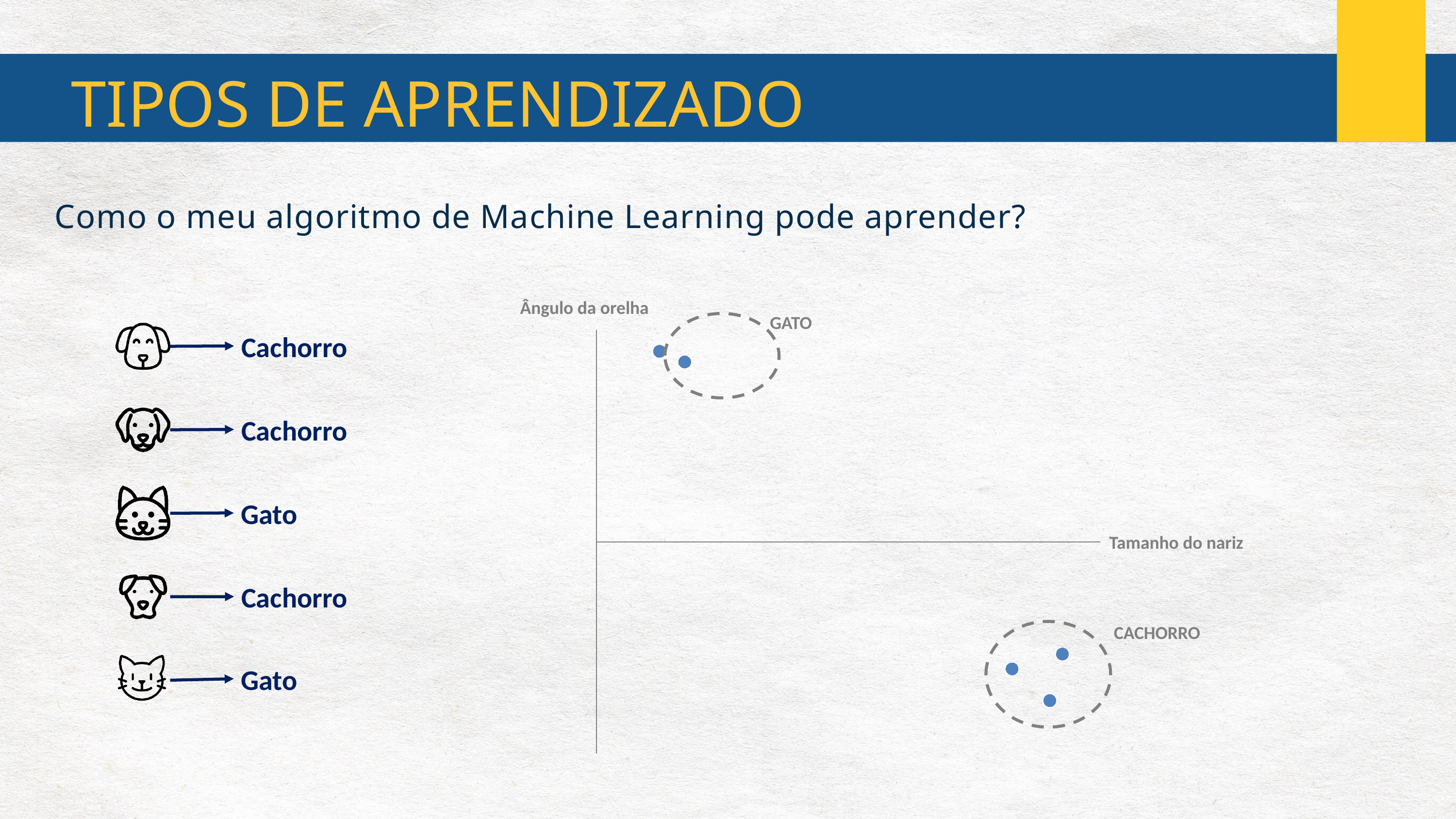
What is the label of the horizontal axis of the scatter chart? Tamanho do nariz As Tamanho do nariz increases along the x axis, do the plotted points' Ângulo da orelha values rise or fall? fall Which cluster contains the fewest points? GATO Which cluster contains the most points? CACHORRO Which cluster, GATO or CACHORRO, has the larger values on the Tamanho do nariz axis? CACHORRO What kind of chart is shown on the slide? scatter chart Which cluster, GATO or CACHORRO, has the higher values on the Ângulo da orelha axis? GATO What is the label of the vertical axis of the scatter chart? Ângulo da orelha How many data points are plotted in the scatter chart? 5 How many labelled clusters are circled in the scatter chart? 2 How many points are inside the cluster labelled GATO? 2